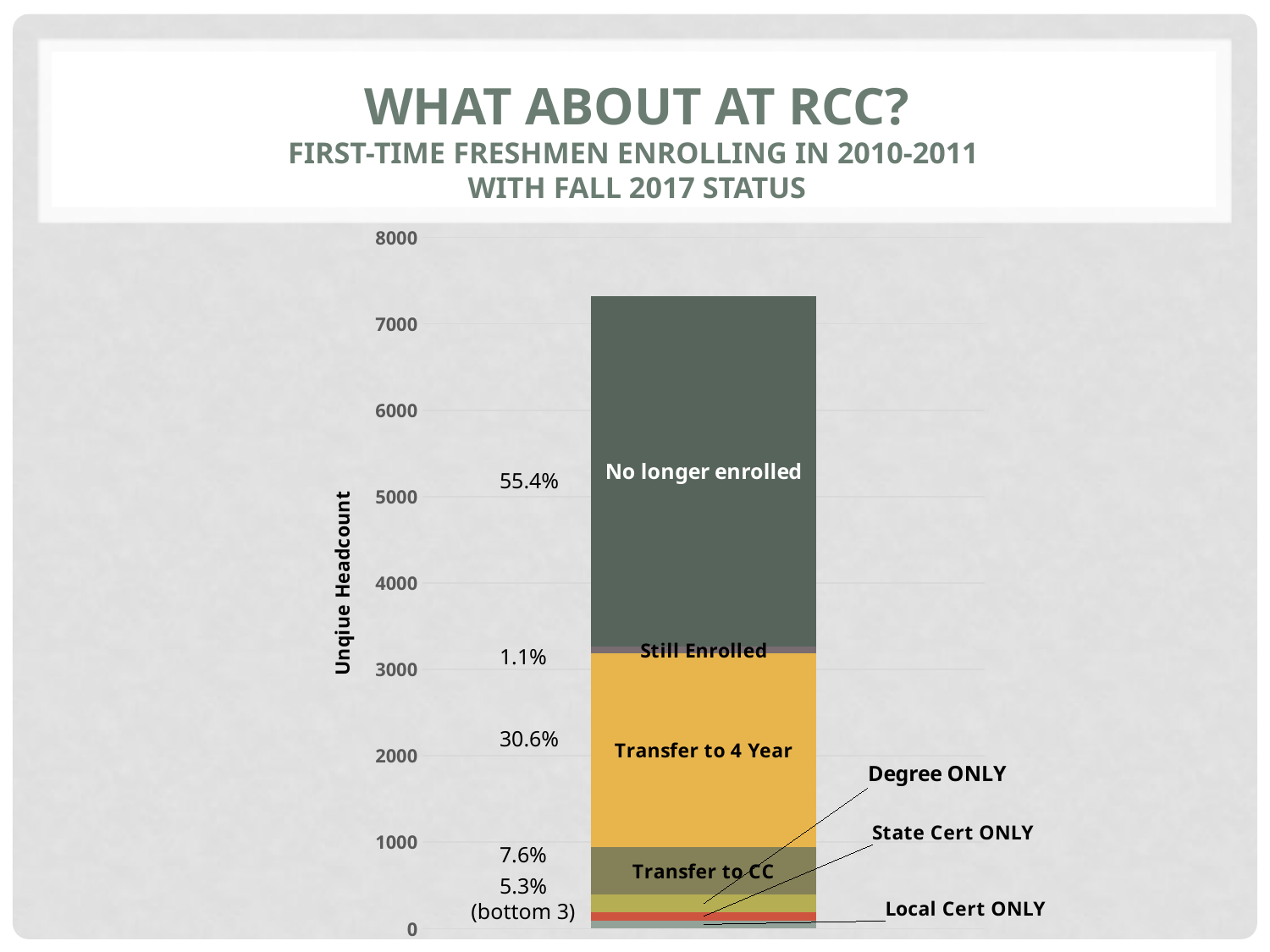
What percentage is shown for the 'Transfer to 4 Year' segment? 30.6% What percentage is shown for the 'Still Enrolled' segment? 1.1% Which individually labelled percentage segment is the smallest? Still Enrolled What combined percentage is shown for the bottom 3 segments (Degree ONLY, State Cert ONLY, Local Cert ONLY)? 5.3% What percentage is shown for the 'Transfer to CC' segment? 7.6% Is the total height of the stacked bar greater or less than 7000 on the Unqiue Headcount axis? greater Which segment is larger, 'Transfer to 4 Year' or 'Transfer to CC'? Transfer to 4 Year Which segment of the stacked bar has the largest share? No longer enrolled What percentage of the stacked bar is labelled for the 'No longer enrolled' segment? 55.4% How many segments make up the stacked bar? 7 What kind of chart is shown on the slide? Stacked bar chart What is the difference in percentage points between the 'No longer enrolled' and 'Transfer to 4 Year' segments? 24.8